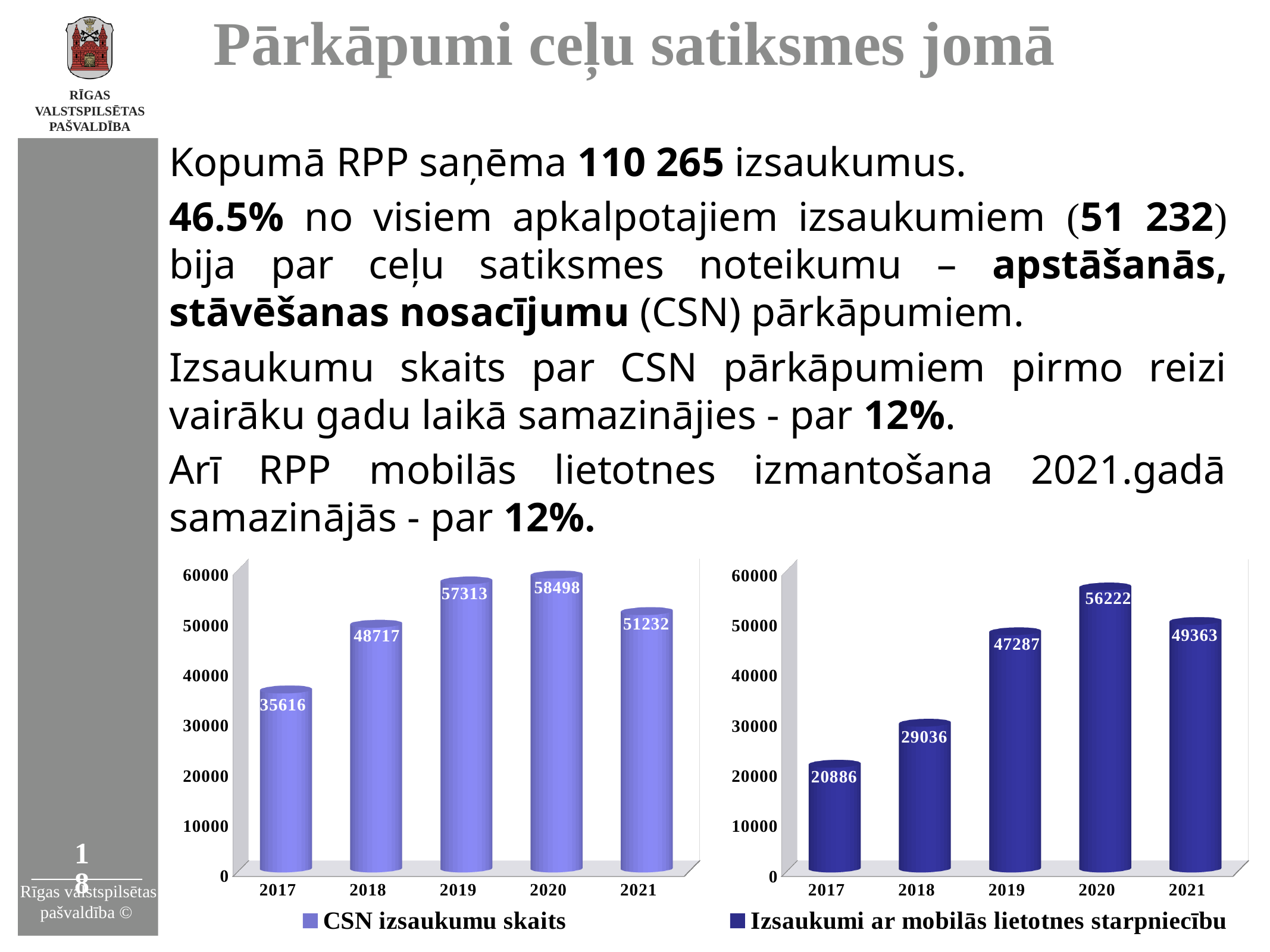
In the right chart (Izsaukumi ar mobilās lietotnes starpniecību), what is the difference between the values for 2020 and 2017? 35336 In the left chart (CSN izsaukumu skaits), what is the value for 2019? 57313 In the left chart (CSN izsaukumu skaits), is the value for 2017 greater or less than 40000? less In the right chart (Izsaukumi ar mobilās lietotnes starpniecību), do the values rise or fall from 2017 to 2020? rise How many years are shown on the x axis of the left chart (CSN izsaukumu skaits)? 5 How many series does the legend of the left chart list? 1 In the right chart (Izsaukumi ar mobilās lietotnes starpniecību), what is the value for 2018? 29036 In the left chart (CSN izsaukumu skaits), what is the difference between the values for 2020 and 2021? 7266 What kind of chart is the right chart (Izsaukumi ar mobilās lietotnes starpniecību)? bar chart In the right chart (Izsaukumi ar mobilās lietotnes starpniecību), which year has the lowest value? 2017 In the left chart (CSN izsaukumu skaits), which year has the highest value? 2020 In the right chart (Izsaukumi ar mobilās lietotnes starpniecību), which is larger, the value for 2019 or the value for 2021? 2021